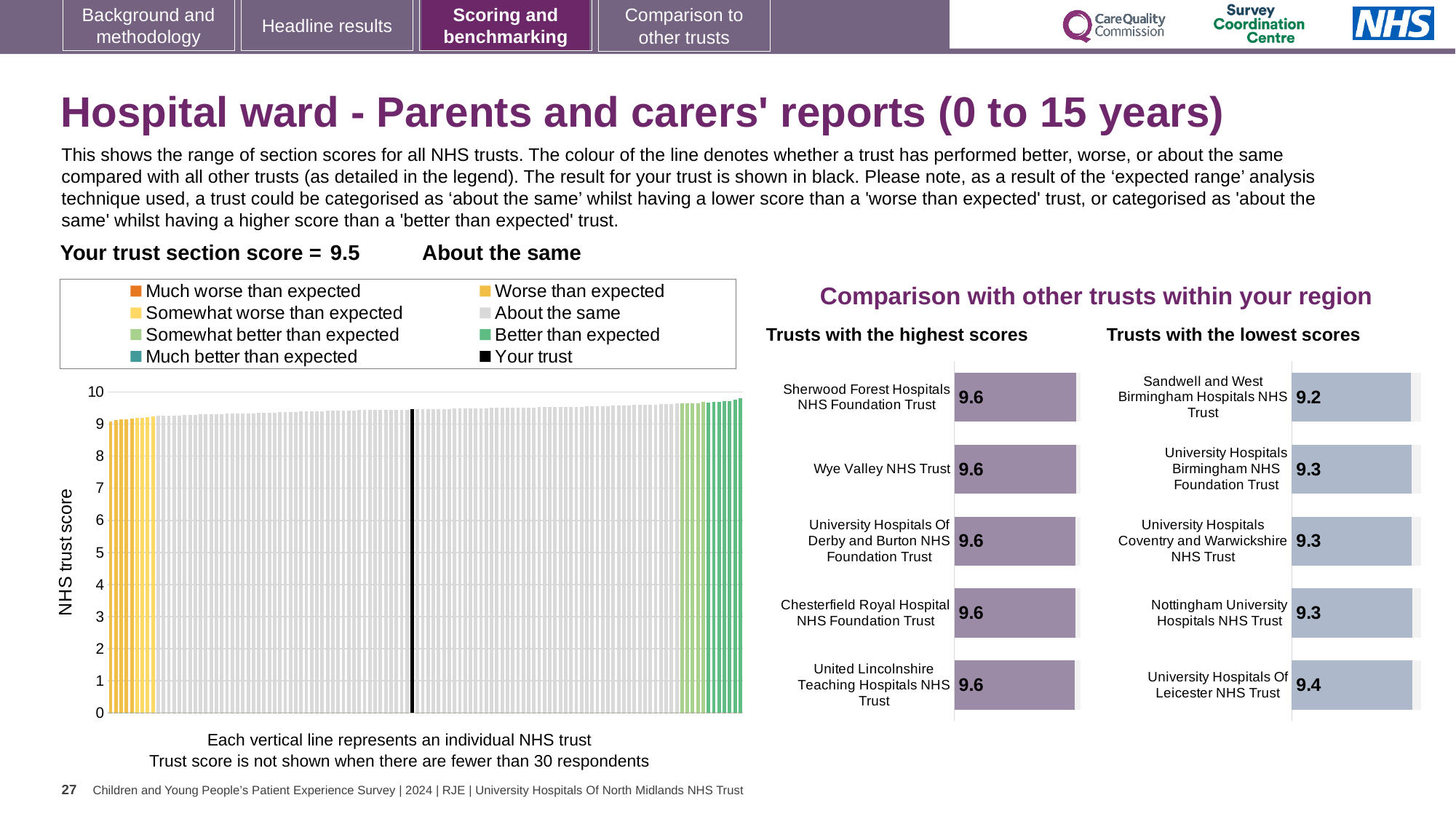
How many trusts are listed in the 'Trusts with the highest scores' chart? 5 In the 'Trusts with the highest scores' chart, what is the score for Wye Valley NHS Trust? 9.6 In the 'Trusts with the lowest scores' chart, what is the score for Sandwell and West Birmingham Hospitals NHS Trust? 9.2 In the 'Trusts with the lowest scores' chart, which has the larger score: Nottingham University Hospitals NHS Trust or Sandwell and West Birmingham Hospitals NHS Trust? Nottingham University Hospitals NHS Trust In the 'Trusts with the lowest scores' chart, what is the score for University Hospitals Of Leicester NHS Trust? 9.4 In the 'Trusts with the lowest scores' chart, which trust has the highest score? University Hospitals Of Leicester NHS Trust In the main chart on the left showing all NHS trusts, do the values rise or fall from left to right along the x axis? Rise In the 'Trusts with the lowest scores' chart, what is the difference between the scores of University Hospitals Of Leicester NHS Trust and Sandwell and West Birmingham Hospitals NHS Trust? 0.2 How many entries does the legend of the main chart on the left list? 8 In the 'Trusts with the lowest scores' chart, which trust has the lowest score? Sandwell and West Birmingham Hospitals NHS Trust What is the y-axis label of the main chart on the left? NHS trust score What kind of chart is the 'Trusts with the lowest scores' chart? Bar chart